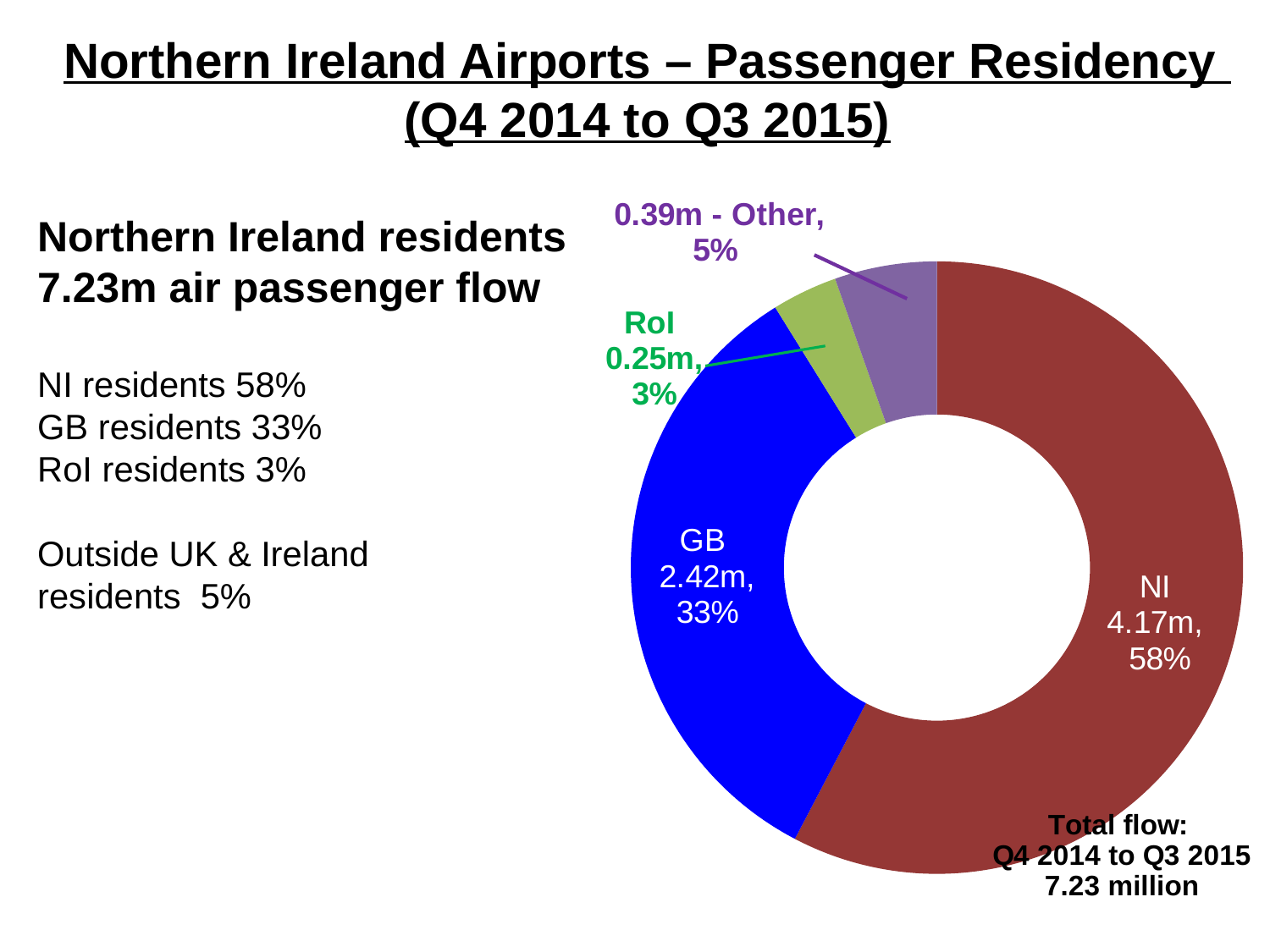
How many categories are shown in the chart? 4 Which category has the largest slice? NI What share of the chart does the GB slice represent? 33% What is the passenger flow for RoI residents? 0.25m Which is larger, the Other slice or the RoI slice? Other What kind of chart is shown on the slide? Doughnut (pie) chart What is the passenger flow for NI residents? 4.17m What share of the chart does the Other slice represent? 5% What is the difference in passenger flow between NI and GB residents? 1.75m What is the passenger flow for GB residents? 2.42m What is the passenger flow for the Other category? 0.39m Which category has the smallest slice? RoI